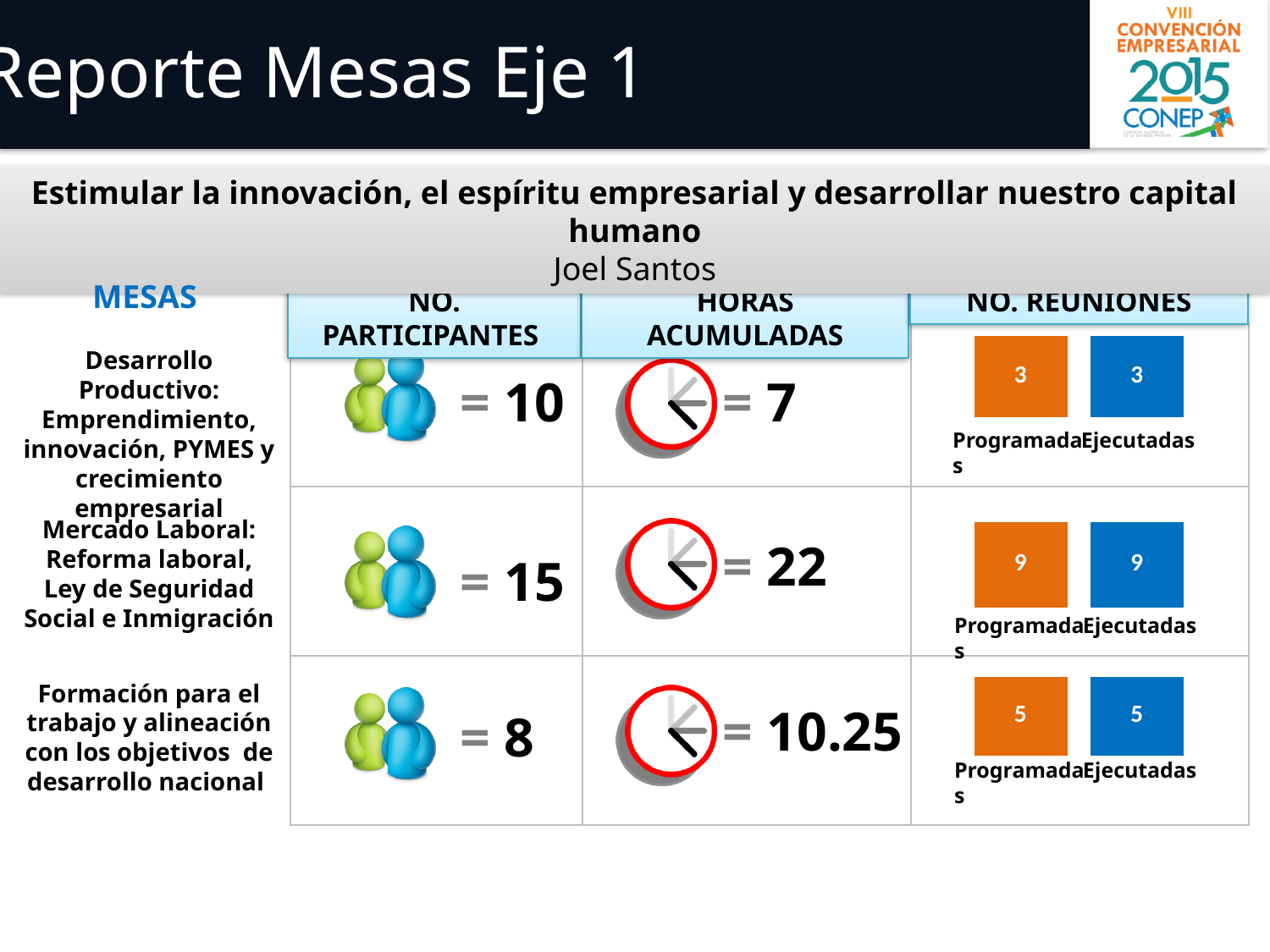
In the NO. REUNIONES chart for the third row (Formación para el trabajo), what is the value for Programadas? 5 In the NO. REUNIONES chart for the third row (Formación para el trabajo), what is the value for Ejecutadas? 5 In the NO. REUNIONES chart for the first row (Desarrollo Productivo), what is the value for Programadas? 3 What kind of chart is used in the NO. REUNIONES column for each row? Bar chart In the NO. REUNIONES chart for the second row (Mercado Laboral), what is the difference between Programadas and Ejecutadas? 0 In the NO. REUNIONES chart for the first row (Desarrollo Productivo), what is the value for Ejecutadas? 3 What colour is the Ejecutadas bar in the NO. REUNIONES charts? Blue How many bars does the NO. REUNIONES chart for the second row (Mercado Laboral) have? 2 In the NO. REUNIONES chart for the second row (Mercado Laboral), what is the value for Programadas? 9 What colour is the Programadas bar in the NO. REUNIONES charts? Orange In the NO. REUNIONES chart for the third row (Formación para el trabajo), what is the difference between Programadas and Ejecutadas? 0 In the NO. REUNIONES chart for the second row (Mercado Laboral), what is the value for Ejecutadas? 9